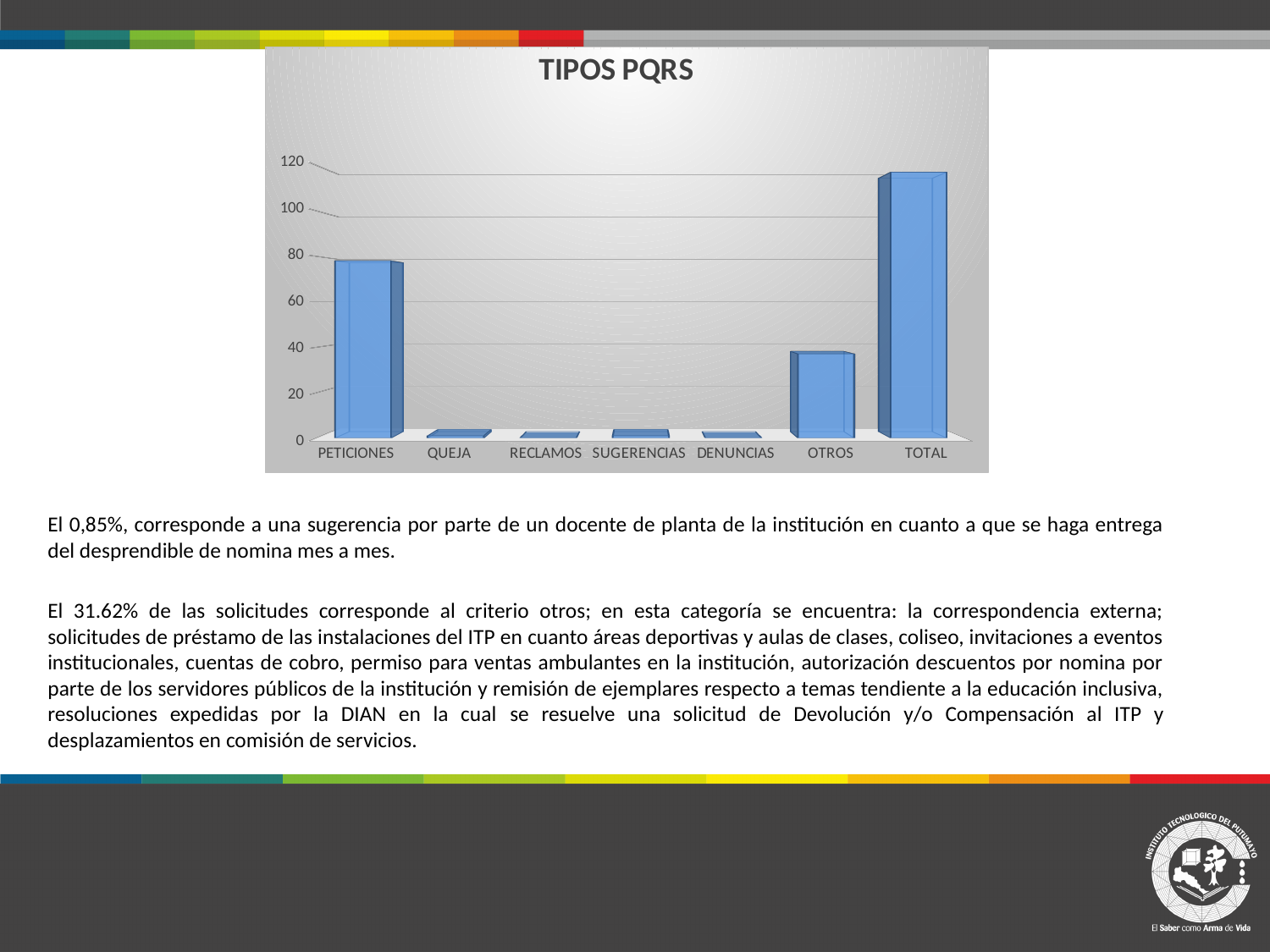
Is the value for OTROS greater or less than 20? greater Is the value for PETICIONES greater or less than 60? greater What kind of chart is shown on the slide? bar chart Is the value for QUEJA greater or less than 20? less Which category has the highest bar in the chart? TOTAL Which is larger, the value for PETICIONES or the value for OTROS? PETICIONES Which is larger, the value for DENUNCIAS or the value for OTROS? OTROS How many categories are shown on the x axis of the chart? 7 What is the title of the chart? TIPOS PQRS